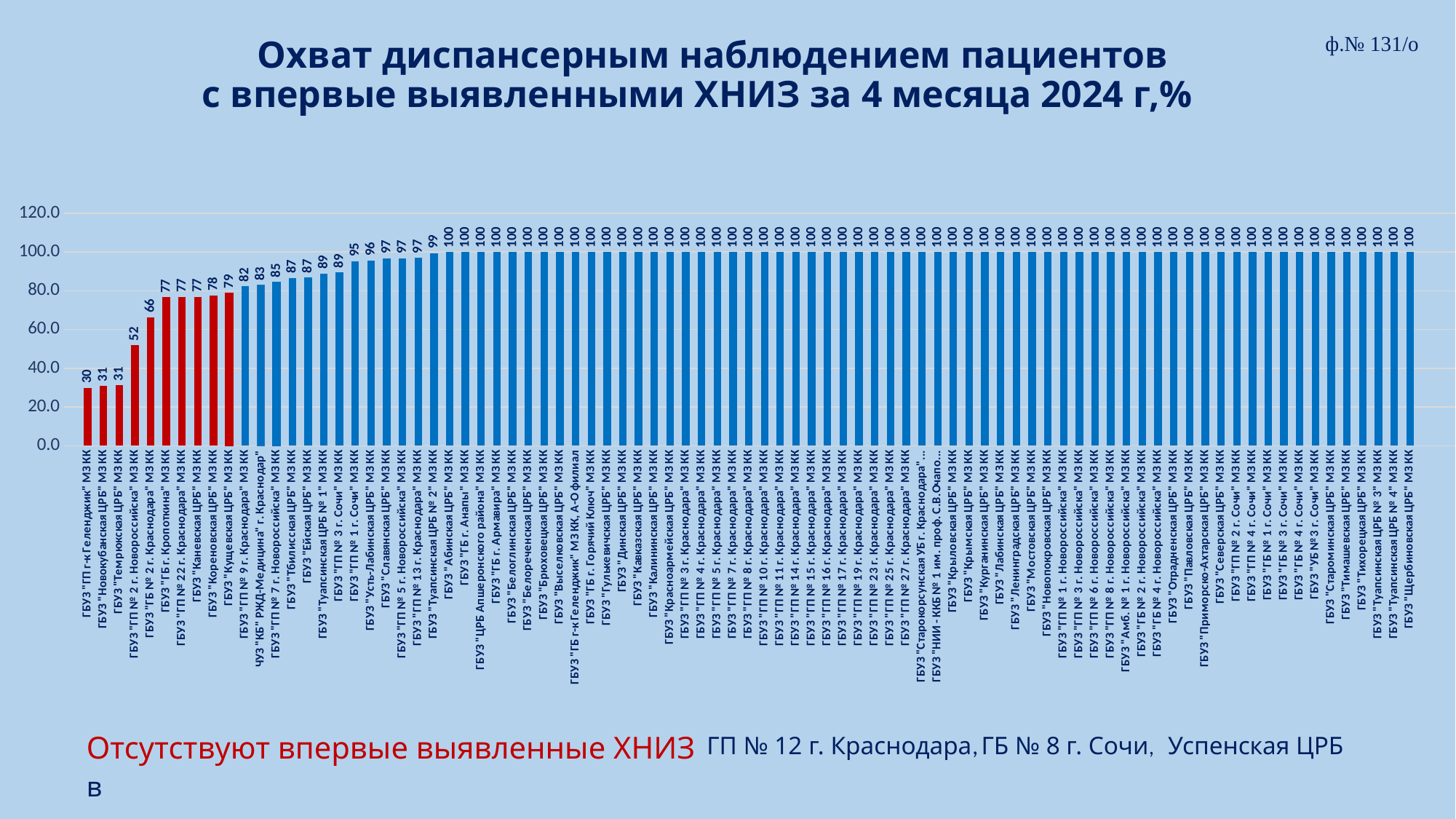
Do the values rise or fall from left to right along the x axis? rise Which category has the lowest value? ГБУЗ "ГП г-к Геленджик" МЗ КК What is the value for ГБУЗ "Туапсинская ЦРБ № 2" МЗ КК? 99 How many bars are coloured red? 10 What is the value for ГБУЗ "ГП г-к Геленджик" МЗ КК? 30 What is the value for ГБУЗ "Кущевская ЦРБ" МЗ КК? 79 What is the value for ГБУЗ "ГП № 2 г. Новороссийска" МЗ КК? 52 What kind of chart is shown on the slide? bar chart Which is larger, the value for ГБУЗ "Кореновская ЦРБ" МЗ КК or the value for ГБУЗ "ГП № 9 г. Краснодара" МЗ КК? ГБУЗ "ГП № 9 г. Краснодара" МЗ КК Is the value for ГБУЗ "Новокубанская ЦРБ" МЗ КК greater or less than 40? less